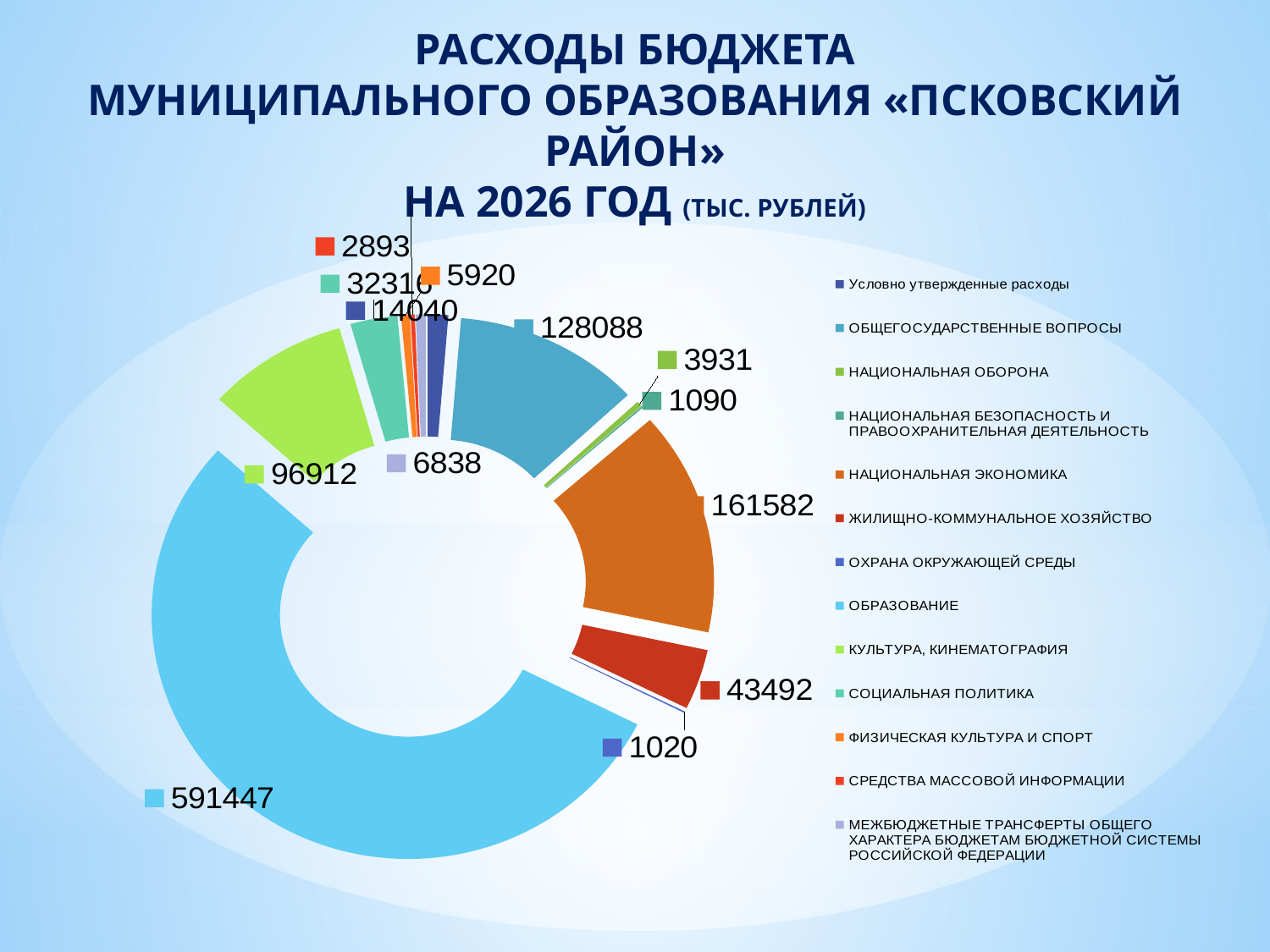
What is the value for НАЦИОНАЛЬНАЯ ЭКОНОМИКА? 161582 Which category has the largest share of the budget expenses? ОБРАЗОВАНИЕ What is the value for ОБЩЕГОСУДАРСТВЕННЫЕ ВОПРОСЫ? 128088 Which category has the smallest value? ОХРАНА ОКРУЖАЮЩЕЙ СРЕДЫ What is the value for ЖИЛИЩНО-КОММУНАЛЬНОЕ ХОЗЯЙСТВО? 43492 What kind of chart is shown on the slide? Doughnut (pie) chart Which is larger: НАЦИОНАЛЬНАЯ ОБОРОНА or НАЦИОНАЛЬНАЯ БЕЗОПАСНОСТЬ И ПРАВООХРАНИТЕЛЬНАЯ ДЕЯТЕЛЬНОСТЬ? НАЦИОНАЛЬНАЯ ОБОРОНА What is the value for ОБРАЗОВАНИЕ? 591447 What is the value for КУЛЬТУРА, КИНЕМАТОГРАФИЯ? 96912 In what units are the values on the chart given, according to the title? тыс. рублей How many expense categories does the legend list? 13 What is the difference between НАЦИОНАЛЬНАЯ ЭКОНОМИКА and ОБЩЕГОСУДАРСТВЕННЫЕ ВОПРОСЫ? 33494